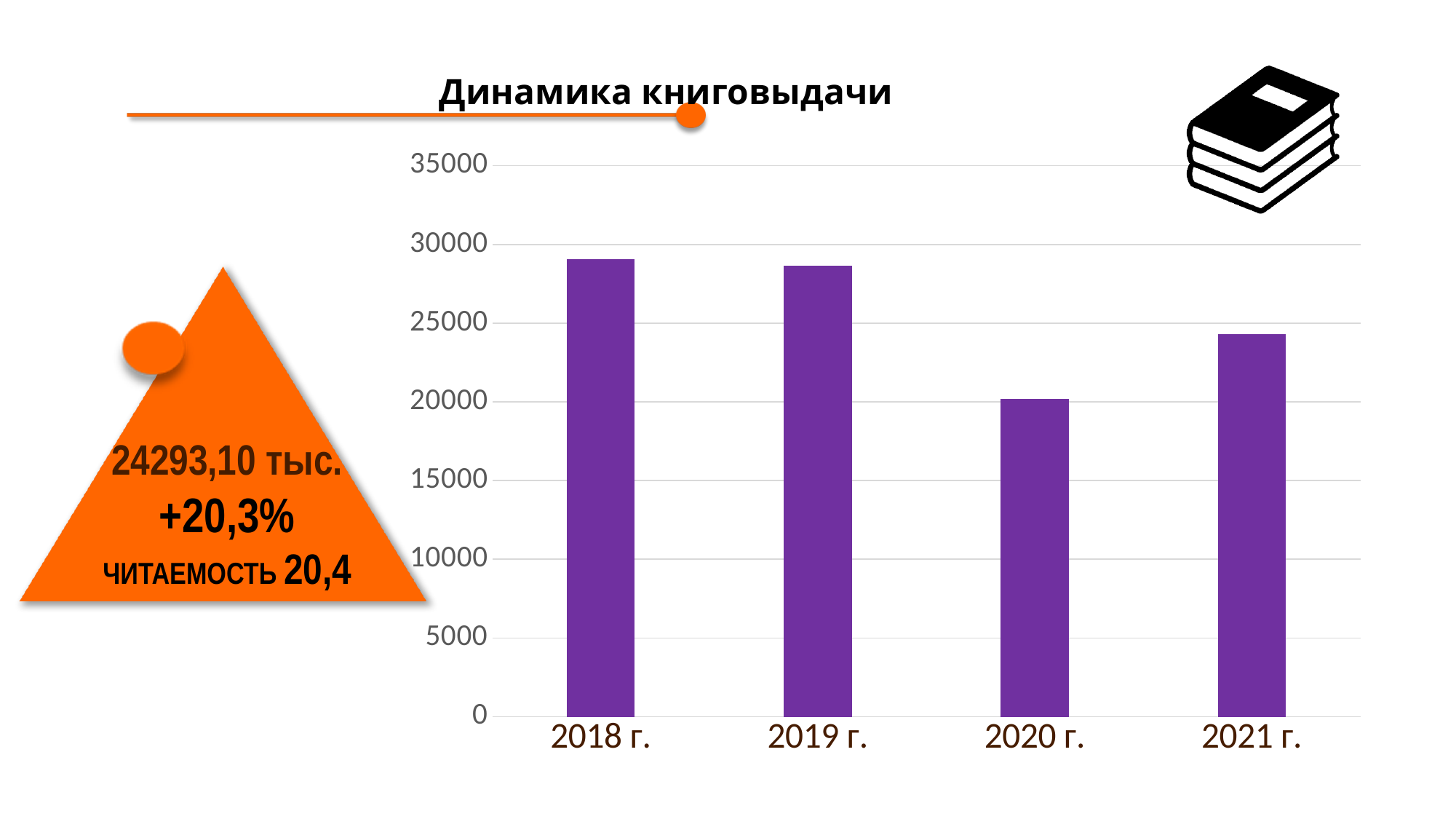
Which is larger, the value for 2020 г. or the value for 2021 г.? 2021 г. How do the values change from 2018 г. to 2020 г.? they fall Which is larger, the value for 2018 г. or the value for 2020 г.? 2018 г. Which year has the lowest bar in the chart? 2020 г. What is the title of the chart? Динамика книговыдачи Is the value for 2018 г. greater or less than 30000? less Is the value for 2019 г. greater or less than 25000? greater How many years are shown on the x axis of the chart? 4 Is the value for 2021 г. greater or less than 20000? greater What kind of chart is shown on the slide? bar chart What colour are the bars in the chart? purple